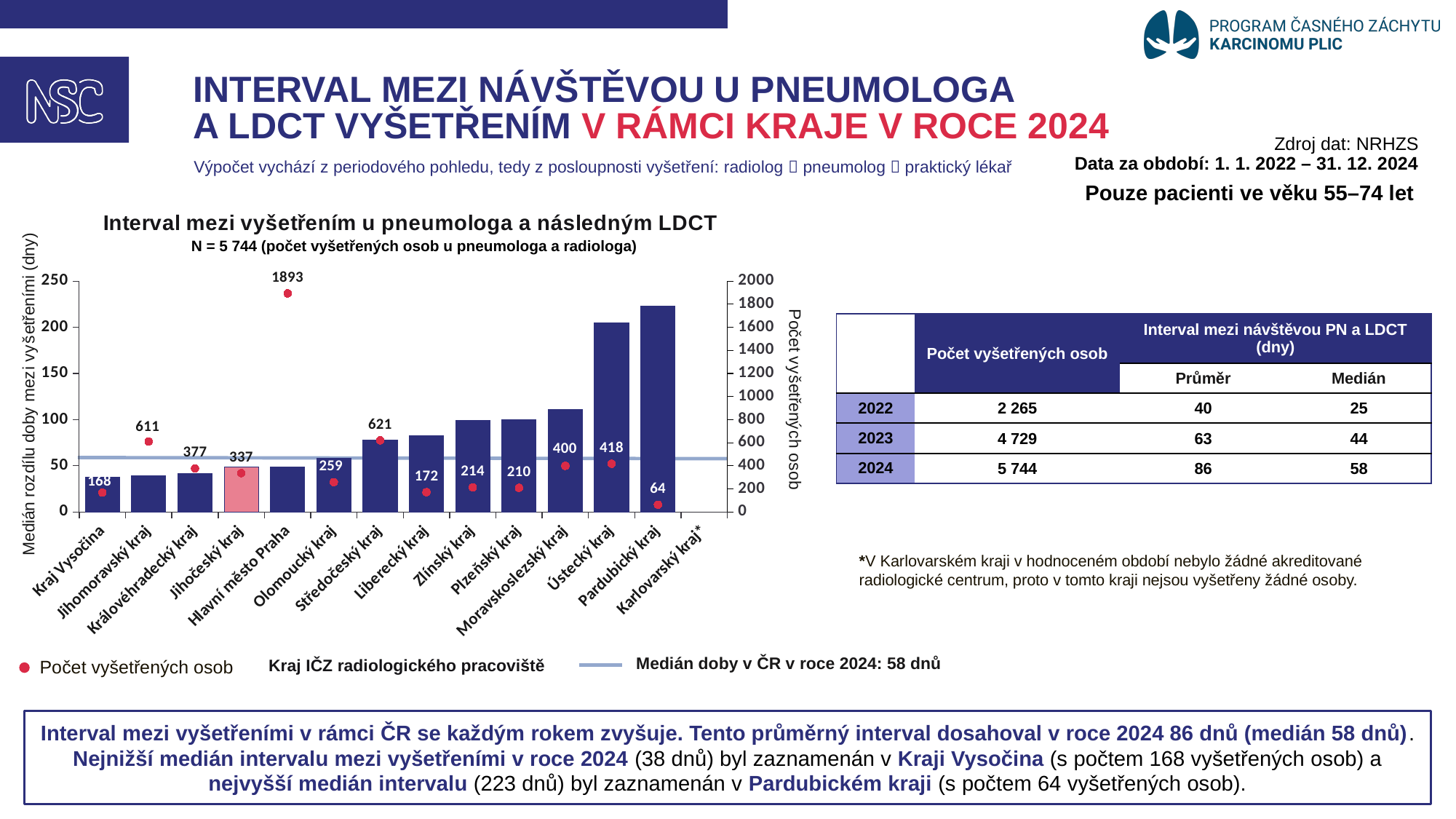
Is the median interval bar for Pardubický kraj greater or less than 200 days? greater Is the median interval bar for Liberecký kraj greater or less than 100 days? less Which region has the tallest median interval bar? Pardubický kraj Which region has the highest number of examined persons? Hlavní město Praha What is the difference between the number of examined persons in Jihomoravský kraj and Kraj Vysočina? 443 Do the median interval bars rise or fall from left to right along the x axis? rise How many regions are listed on the x axis of the chart? 14 What value does the horizontal reference line (Medián doby v ČR v roce 2024) represent? 58 dnů What is the number of examined persons for Středočeský kraj? 621 Among regions with data, which region has the lowest number of examined persons? Pardubický kraj How many examined persons (Počet vyšetřených osob) are shown for Hlavní město Praha? 1893 Which has more examined persons, Ústecký kraj or Moravskoslezský kraj? Ústecký kraj